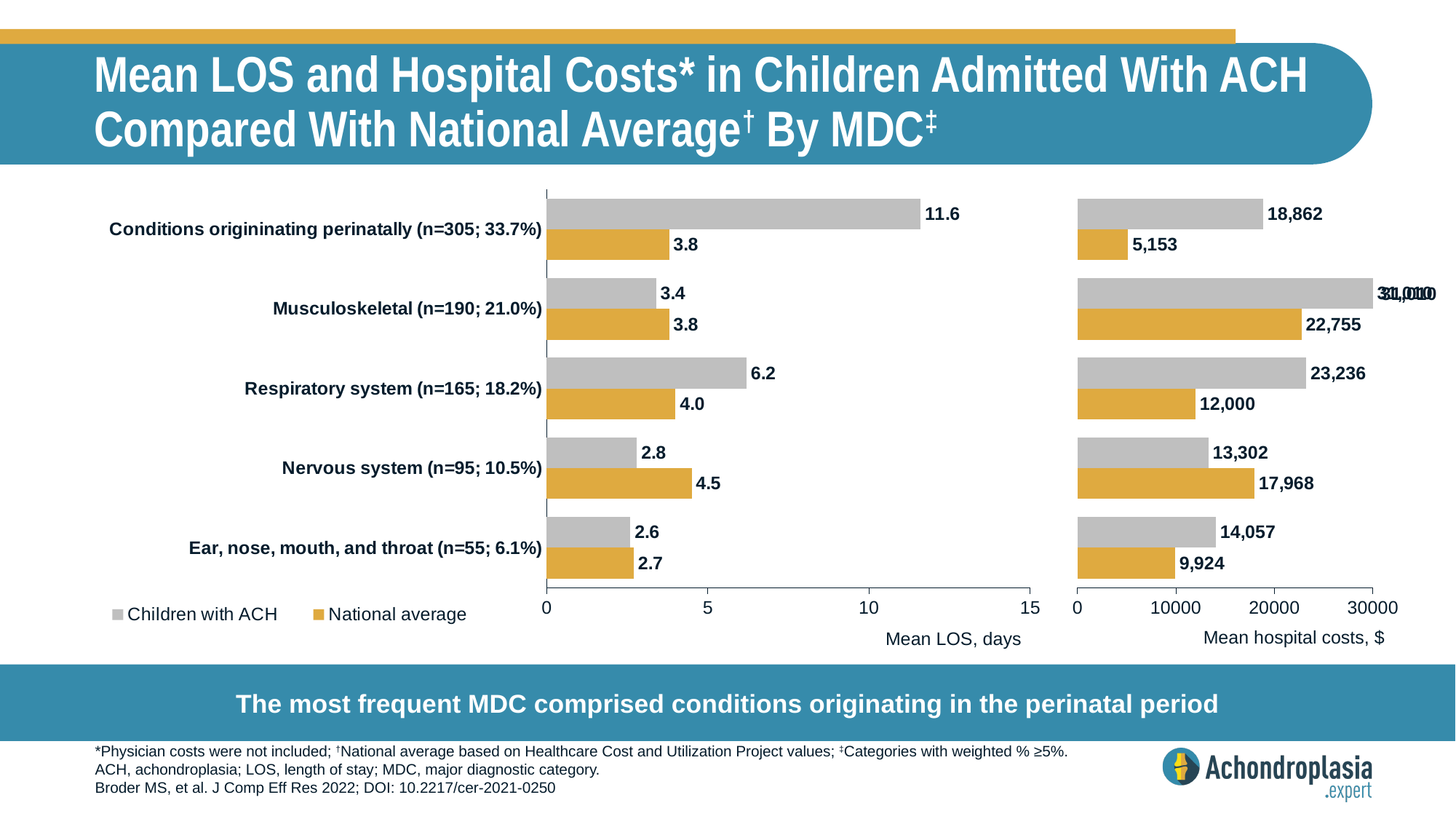
In the Mean hospital costs, $ chart, is the Children with ACH value for the Musculoskeletal category greater or less than 20000? greater In the Mean hospital costs, $ chart, what is the difference between the Children with ACH and National average mean hospital costs for the Respiratory system category? 11,236 In the Mean hospital costs, $ chart, which is larger for the Nervous system category: the Children with ACH cost or the National average cost? National average In the Mean hospital costs, $ chart, which category has the lowest National average mean hospital cost? Conditions origininating perinatally (n=305; 33.7%) In the Mean LOS, days chart, what is the difference between the Children with ACH and National average mean LOS for the Conditions origininating perinatally category? 7.8 How many series does the legend list? 2 In the Mean LOS, days chart, what is the National average mean LOS for the Nervous system category? 4.5 How many categories are shown in the Mean LOS, days chart? 5 In the Mean LOS, days chart, what is the mean LOS for Children with ACH in the Conditions origininating perinatally category? 11.6 In the Mean LOS, days chart, which category has the highest mean LOS for Children with ACH? Conditions origininating perinatally (n=305; 33.7%) In the Mean hospital costs, $ chart, what is the mean hospital cost for Children with ACH in the Respiratory system category? 23,236 In the Mean hospital costs, $ chart, what is the National average mean hospital cost for the Ear, nose, mouth, and throat category? 9,924